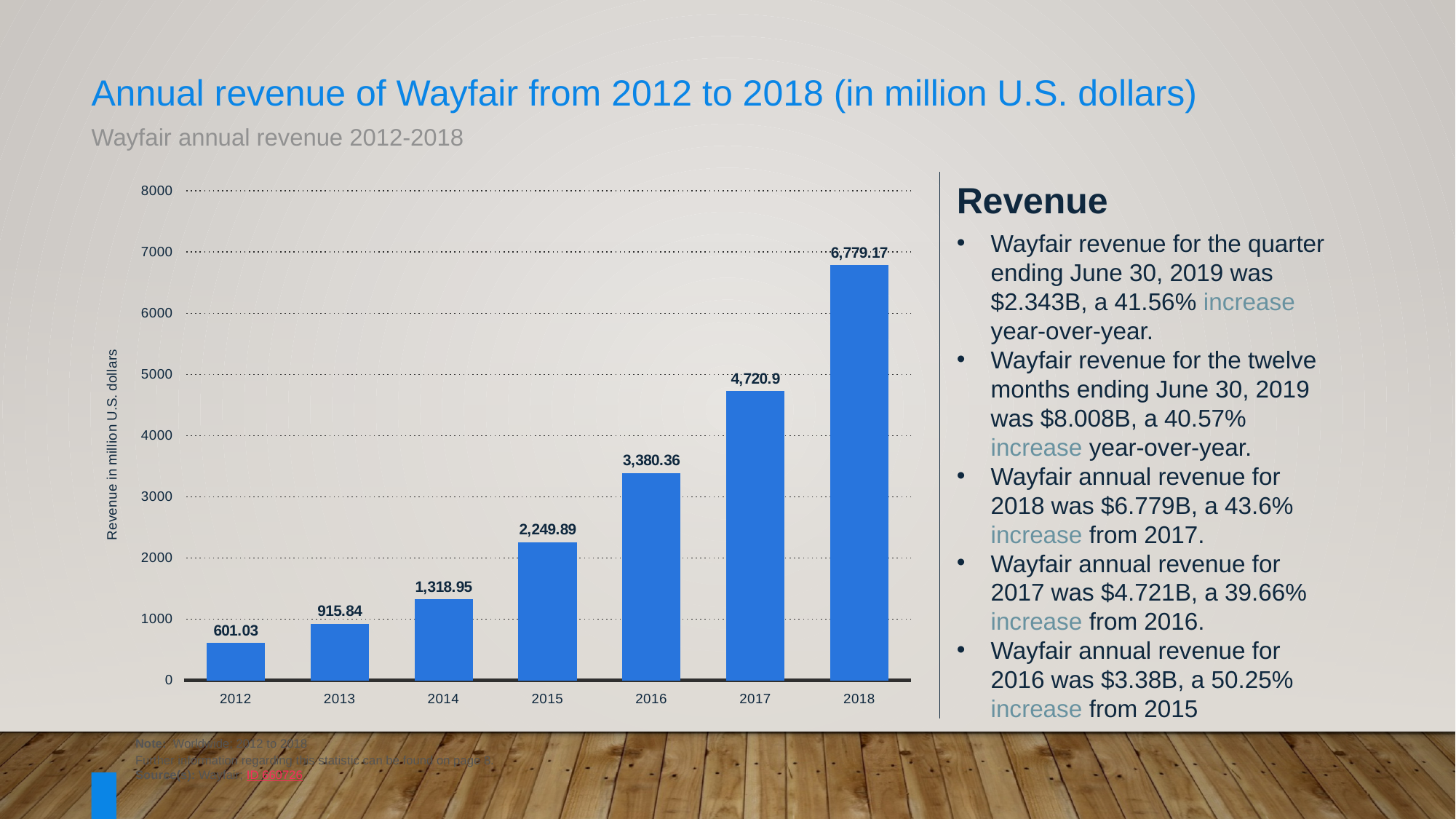
What value is shown for 2017 on the chart? 4,720.9 Do the revenue values rise or fall from 2012 to 2018? rise What is the difference between the 2018 and 2017 revenue values? 2,058.27 Which year has the highest revenue on the chart? 2018 What value is shown for 2012 on the chart? 601.03 How many years are shown on the x axis of the chart? 7 What was Wayfair's revenue in 2015 according to the chart? 2,249.89 What is the difference between the 2014 and 2013 revenue values? 403.11 Is the value for 2016 greater or less than 3000? greater What kind of chart is shown on the slide? bar chart Which year has the lowest revenue on the chart? 2012 Which year has the larger revenue, 2016 or 2015? 2016